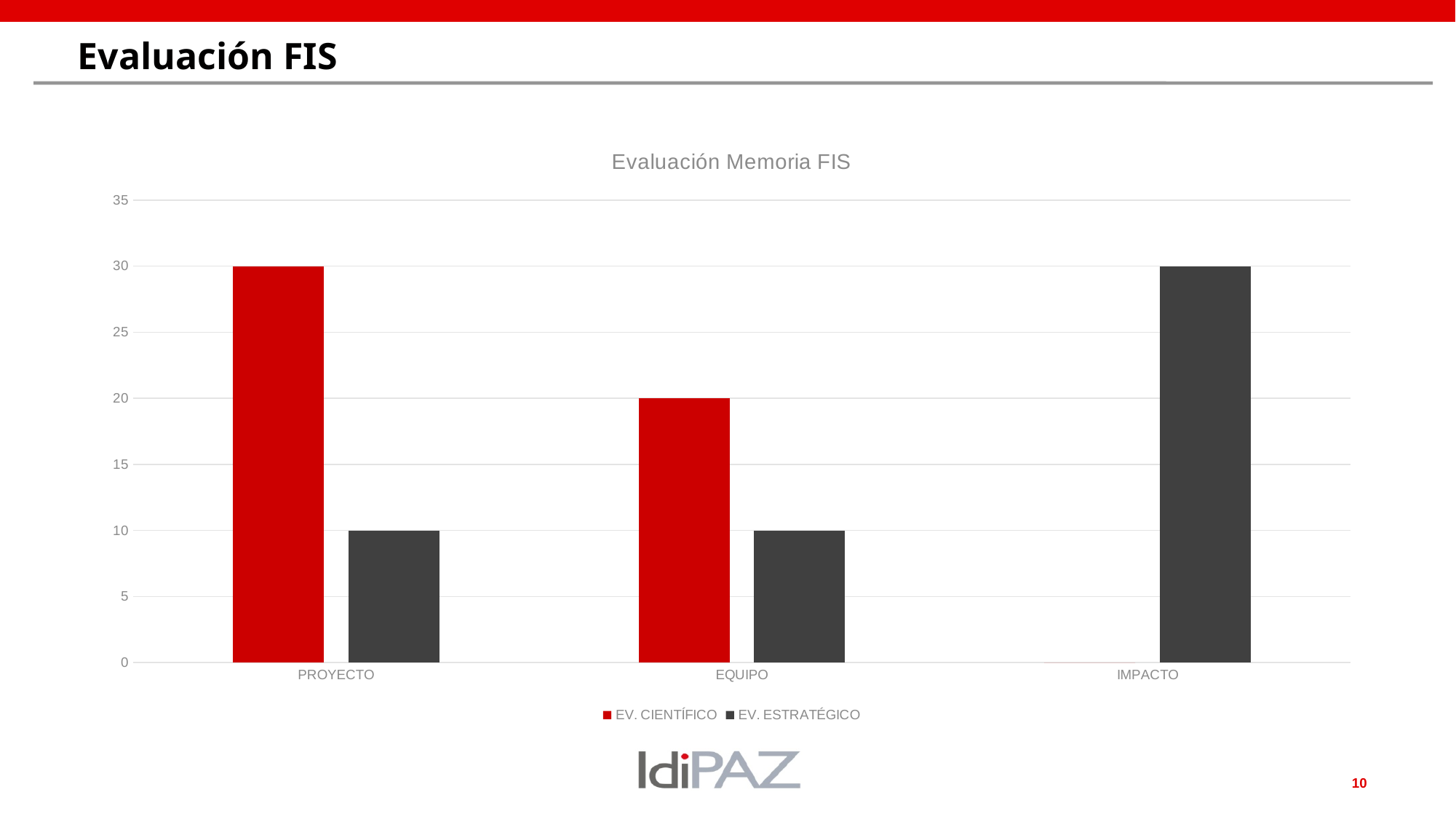
What is the difference between the EV. CIENTÍFICO and EV. ESTRATÉGICO values for PROYECTO? 20 What is the title of the chart? Evaluación Memoria FIS Which category has the highest EV. CIENTÍFICO value? PROYECTO For EQUIPO, which is larger: EV. CIENTÍFICO or EV. ESTRATÉGICO? EV. CIENTÍFICO How many categories are shown on the x axis? 3 How many series does the legend list? 2 What is the EV. ESTRATÉGICO value for IMPACTO? 30 What is the EV. CIENTÍFICO value for EQUIPO? 20 What kind of chart is shown on the slide? bar chart What is the EV. ESTRATÉGICO value for PROYECTO? 10 Which category has the lowest EV. CIENTÍFICO value? IMPACTO What is the EV. CIENTÍFICO value for PROYECTO? 30